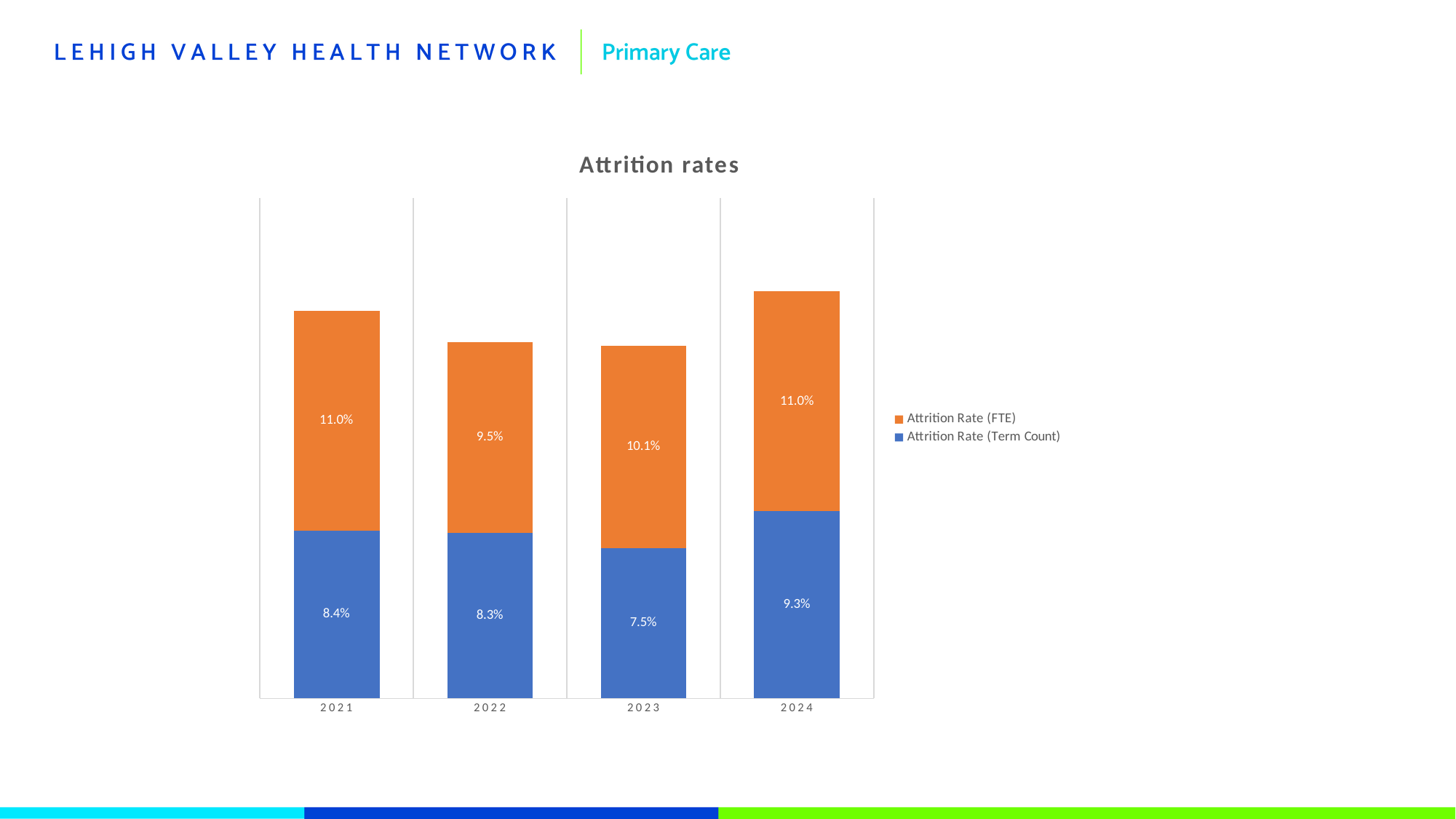
Which year has the lowest Attrition Rate (FTE)? 2022 What is the difference between the Attrition Rate (FTE) and the Attrition Rate (Term Count) in 2024? 1.7 percentage points What is the total of the stacked bar for 2021? 19.4% How many years are shown on the x axis of the chart? 4 How many series does the legend list? 2 What is the Attrition Rate (FTE) for 2022? 9.5% What is the Attrition Rate (Term Count) for 2021? 8.4% Which year has the lowest Attrition Rate (Term Count)? 2023 What is the Attrition Rate (FTE) for 2023? 10.1% What type of chart is shown on the slide? Stacked bar chart Is the Attrition Rate (FTE) for 2023 larger or smaller than the Attrition Rate (FTE) for 2022? larger Which year has the highest Attrition Rate (Term Count)? 2024